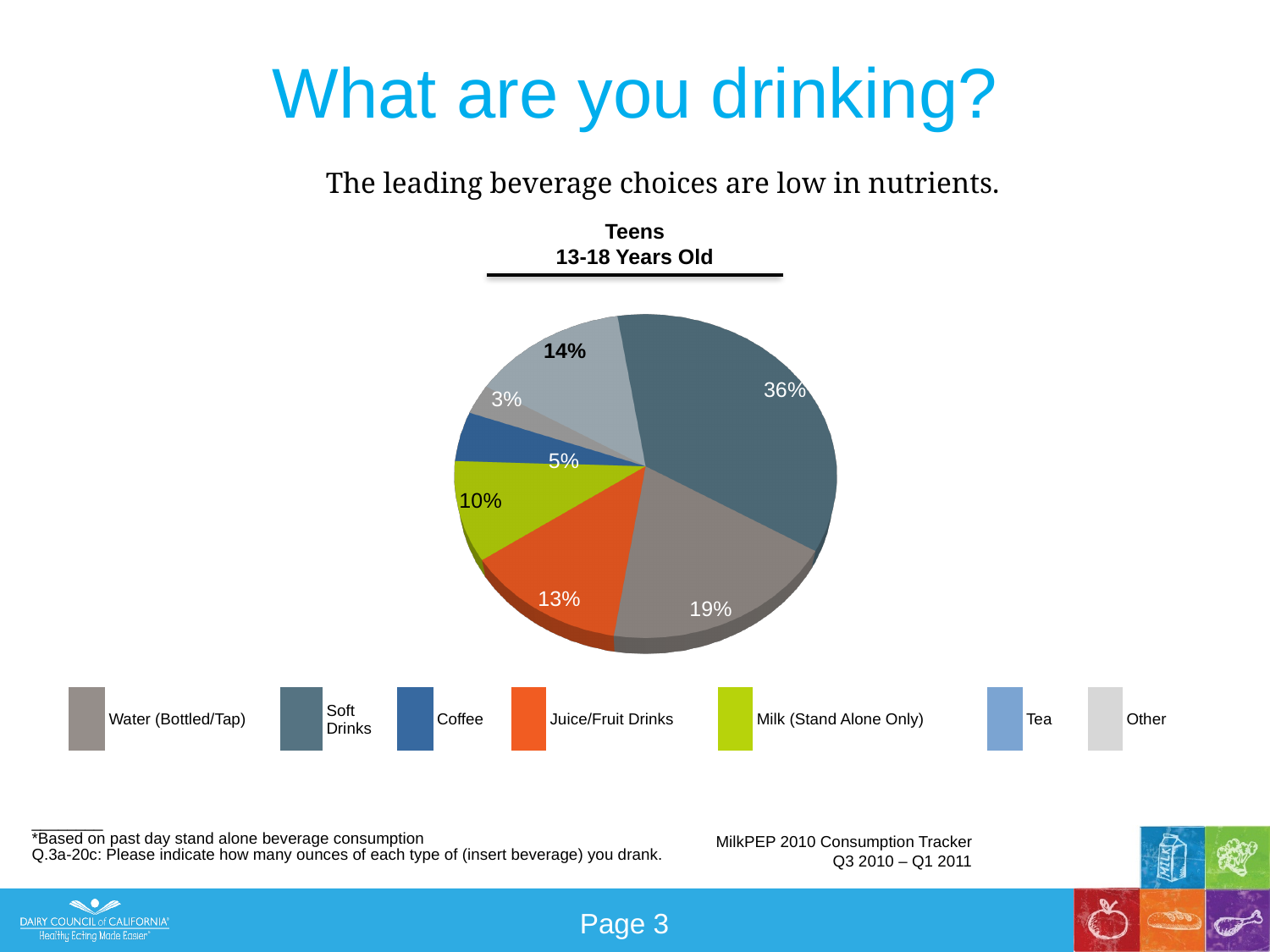
What share of the pie is Coffee? 5% Which beverage has the smallest slice of the pie? Other What is the difference in percentage points between Soft Drinks and Water (Bottled/Tap)? 17 How many beverage categories does the legend list? 7 What share of the pie is Milk (Stand Alone Only)? 10% What type of chart is shown on the slide? pie chart Which is larger, the share for Tea or the share for Juice/Fruit Drinks? Tea What share of the pie is Water (Bottled/Tap)? 19% What share of the pie is Tea? 14% What share of the pie is Soft Drinks? 36% What share of the pie is Juice/Fruit Drinks? 13% Which beverage has the largest slice of the pie? Soft Drinks